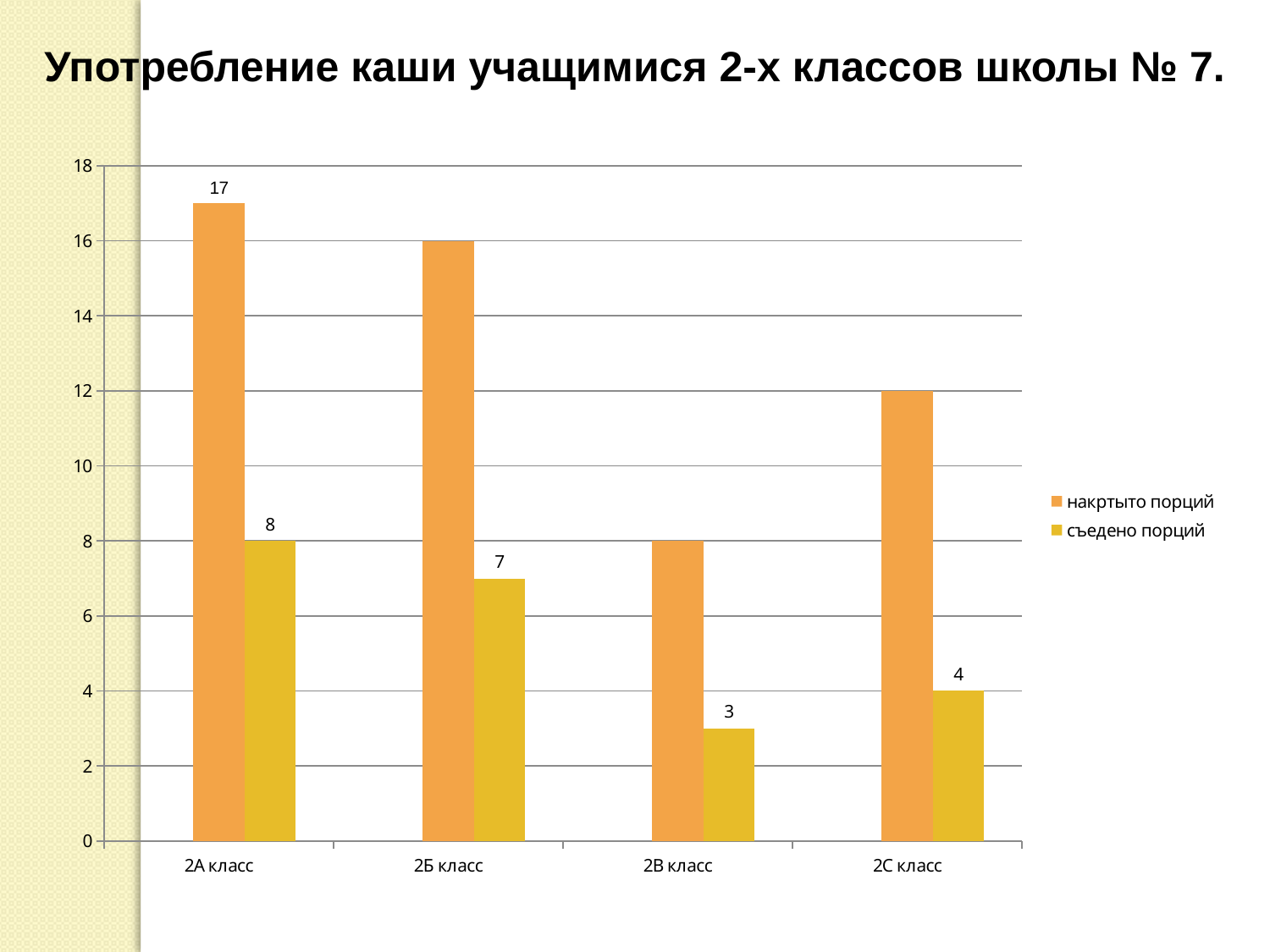
How many classes (categories) are shown on the x axis? 4 How many portions were served (накртыто порций) in 2А класс? 17 How many series does the legend list? 2 How many portions were eaten (съедено порций) in 2С класс? 4 What is the difference between served and eaten portions in 2А класс? 9 How many portions were eaten (съедено порций) in 2Б класс? 7 Which class has the highest number of served portions (накртыто порций)? 2А класс Is the number of served portions (накртыто порций) in 2С класс greater or less than 10? greater Which class has the lowest number of eaten portions (съедено порций)? 2В класс What type of chart is shown on the slide? bar chart How many portions were eaten (съедено порций) in 2В класс? 3 How many portions were eaten (съедено порций) in 2А класс? 8